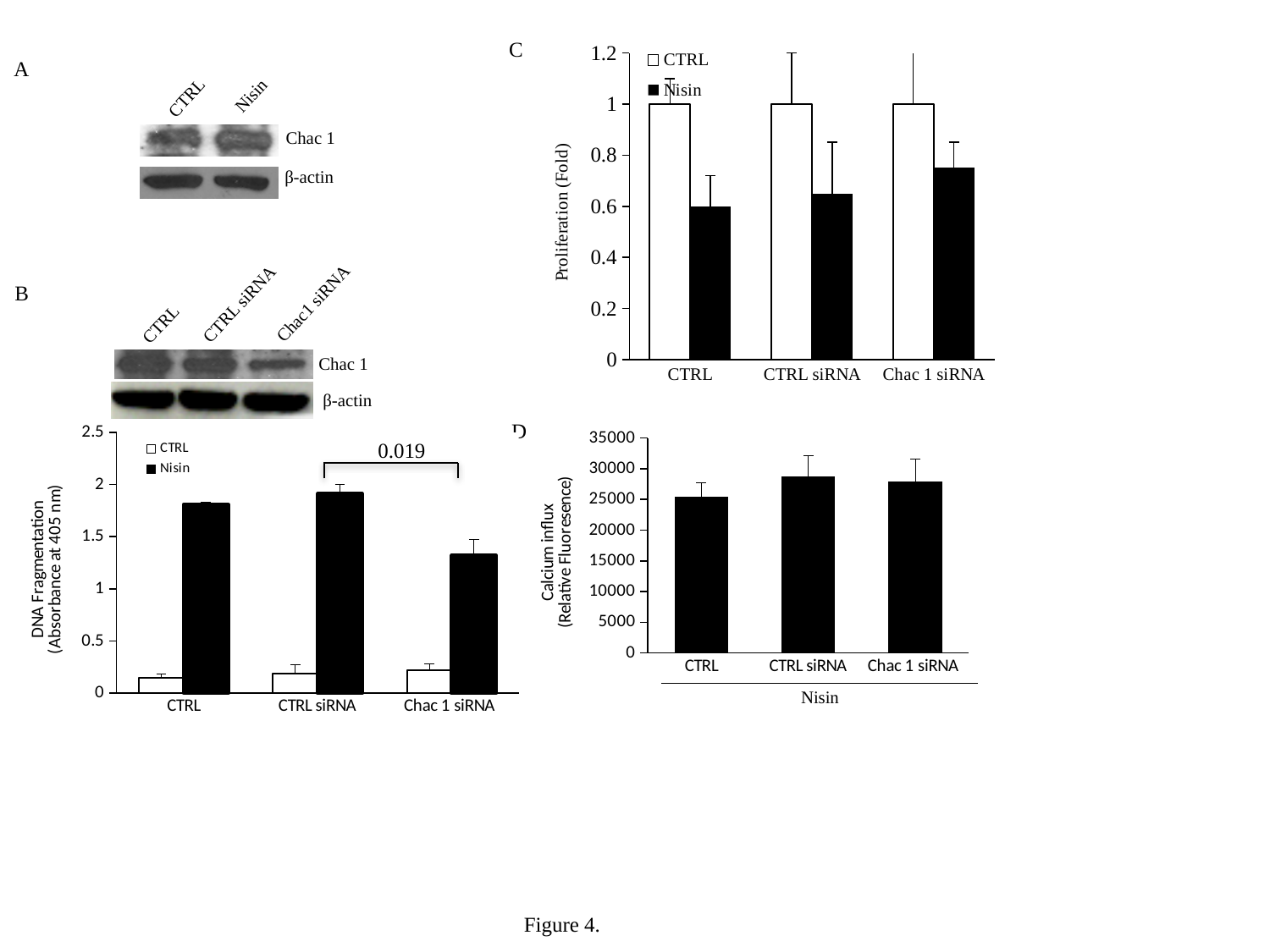
In the Proliferation (Fold) chart, what is the CTRL series value for the CTRL category? 1 What kind of chart is the Proliferation (Fold) chart in the top right? bar chart In the Calcium influx chart, is the value for CTRL greater or less than 20000? greater In the DNA Fragmentation chart, is the Nisin value for Chac 1 siRNA greater or less than 1.5? less In the Calcium influx chart, which category has the lowest value? CTRL In the Proliferation (Fold) chart, how many series does the legend list? 2 In the DNA Fragmentation chart, which is larger: the Nisin value for CTRL siRNA or the Nisin value for Chac 1 siRNA? CTRL siRNA In the Proliferation (Fold) chart, which category has the highest Nisin value? Chac 1 siRNA In the DNA Fragmentation chart, what p-value is printed above the bracket between CTRL siRNA and Chac 1 siRNA? 0.019 In the DNA Fragmentation chart, which category has the lowest Nisin value? Chac 1 siRNA In the Proliferation (Fold) chart, is the Nisin value for CTRL greater or less than 0.8? less In the DNA Fragmentation chart, how many categories are shown on the x axis? 3